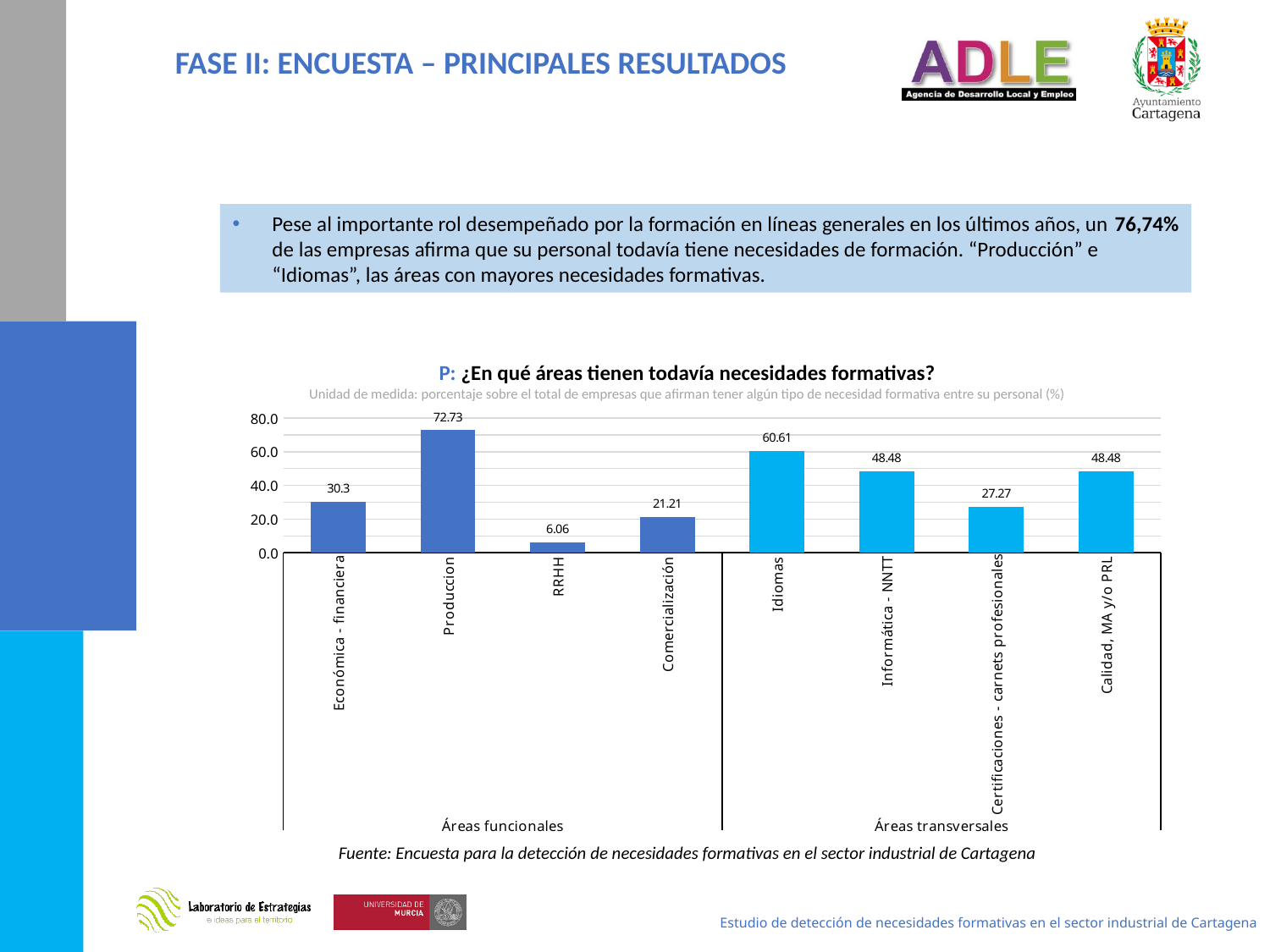
What is the value for Idiomas? 60.61 What is the difference between the values for Produccion and Idiomas? 12.12 What are the two groups into which the categories are divided on the x axis? Áreas funcionales and Áreas transversales Which is larger, the value for Económica - financiera or the value for Comercialización? Económica - financiera What is the value for Produccion? 72.73 What is the value for Certificaciones - carnets profesionales? 27.27 Is the value for Informática - NNTT greater or less than 40.0? greater How many categories are shown on the x axis? 8 Which category has the lowest value? RRHH What kind of chart is shown? bar chart Which category has the highest value? Produccion What is the value for RRHH? 6.06